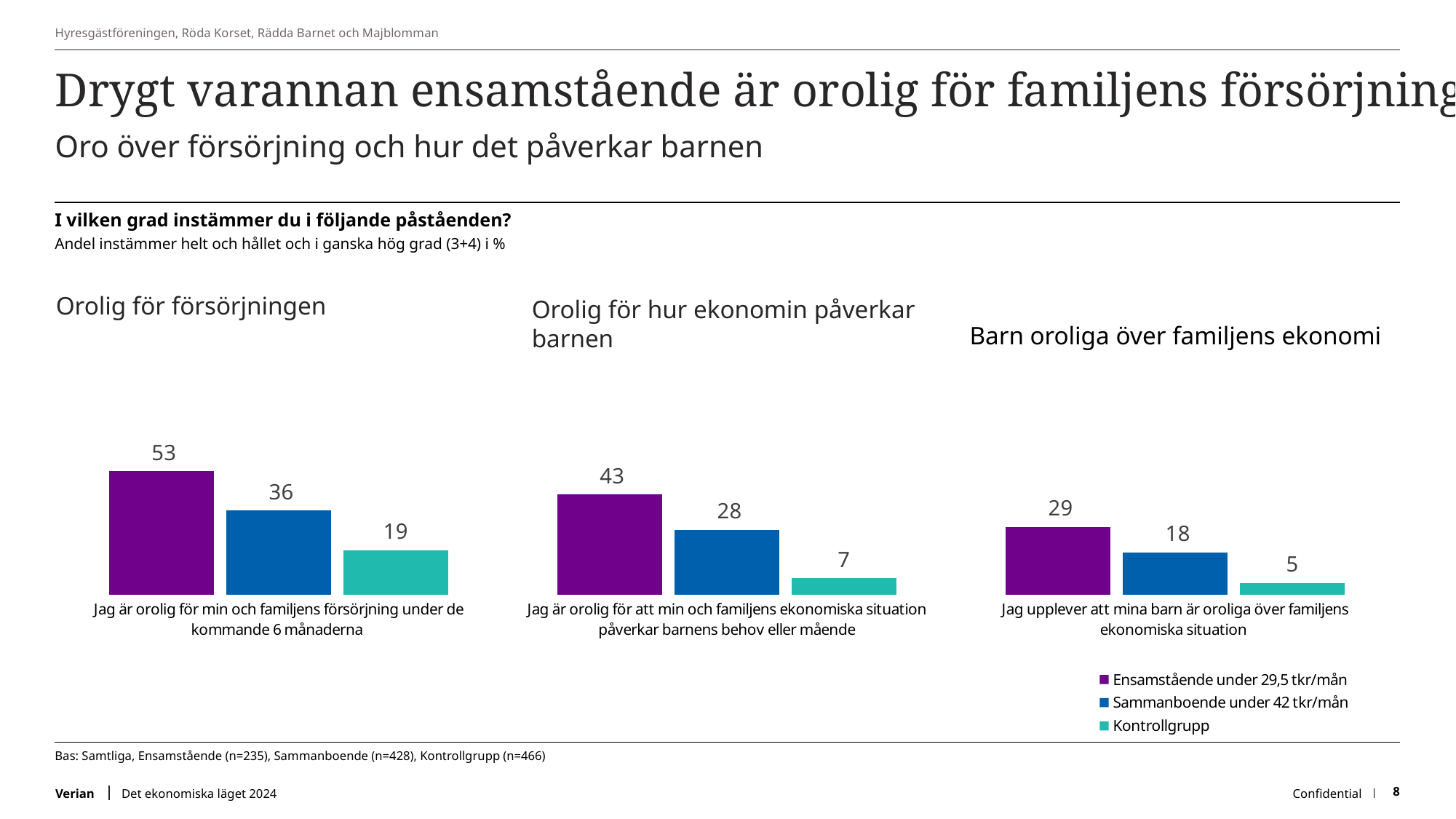
Which is larger: the value for Sammanboende under 42 tkr/mån in 'Orolig för försörjningen' or the value for Ensamstående under 29,5 tkr/mån in 'Barn oroliga över familjens ekonomi'? Sammanboende under 42 tkr/mån in 'Orolig för försörjningen' How many series does the legend list? 3 In the chart 'Orolig för hur ekonomin påverkar barnen', what is the difference between the values for Sammanboende under 42 tkr/mån and Kontrollgrupp? 21 In the chart 'Orolig för hur ekonomin påverkar barnen', which group has the lowest value? Kontrollgrupp In the chart 'Orolig för försörjningen', what is the value for Kontrollgrupp? 19 In the chart 'Orolig för försörjningen', what is the value for Ensamstående under 29,5 tkr/mån? 53 In the chart 'Orolig för hur ekonomin påverkar barnen', what is the value for Sammanboende under 42 tkr/mån? 28 Which colour represents Kontrollgrupp in the legend? Teal In the chart 'Orolig för försörjningen', what is the difference between the values for Ensamstående under 29,5 tkr/mån and Sammanboende under 42 tkr/mån? 17 In the chart 'Barn oroliga över familjens ekonomi', which group has the highest value? Ensamstående under 29,5 tkr/mån In the chart 'Barn oroliga över familjens ekonomi', what is the value for Kontrollgrupp? 5 What kind of chart is 'Orolig för försörjningen'? Bar chart